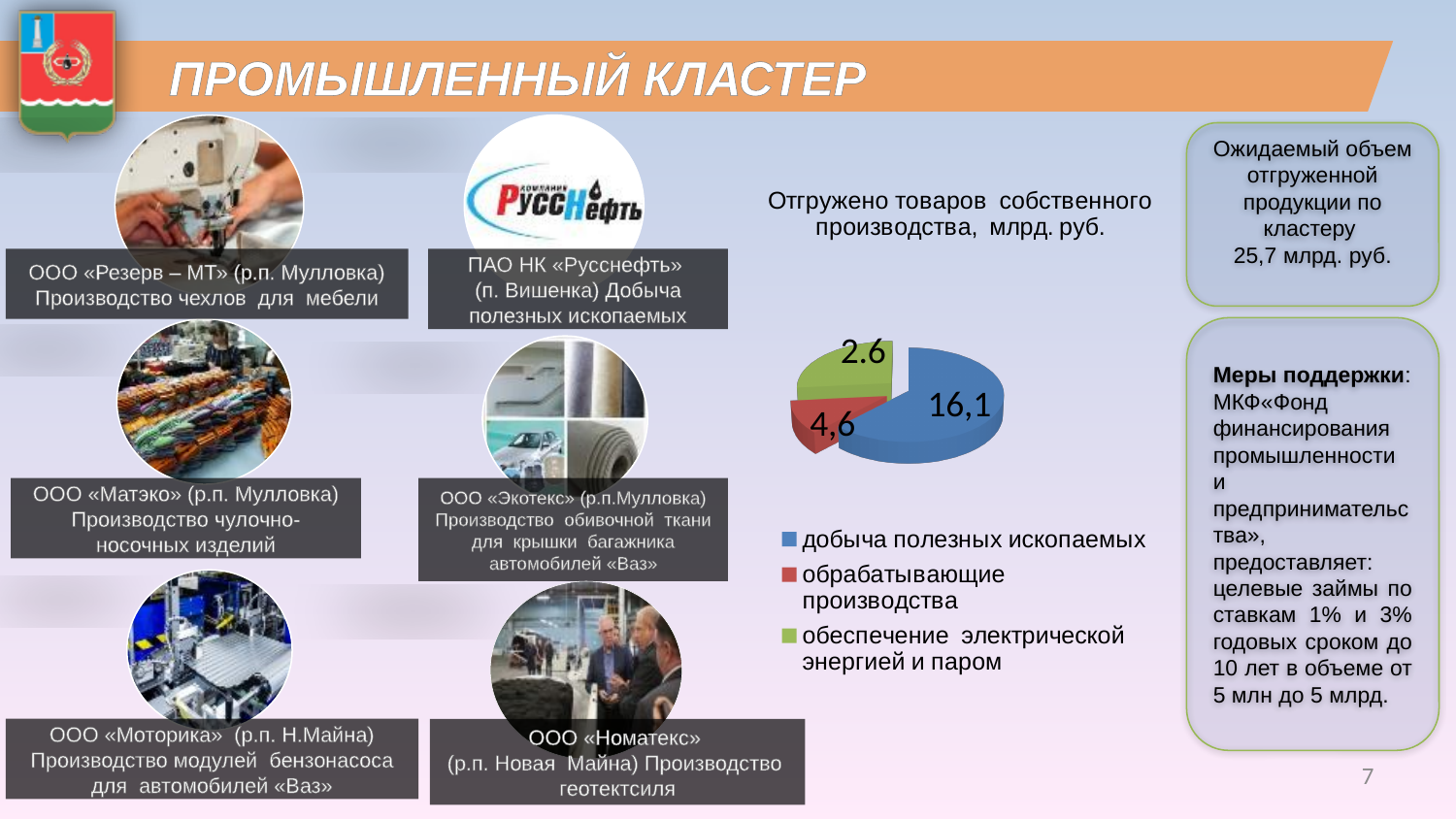
What is the title of the pie chart? Отгружено товаров собственного производства, млрд. руб. Which is larger: the value for обрабатывающие производства or the value for обеспечение электрической энергией и паром? обрабатывающие производства What is the total of all slices in the pie chart? 23,3 What kind of chart is shown on the slide? pie chart What is the value for добыча полезных ископаемых in the pie chart? 16,1 What is the difference between the values for добыча полезных ископаемых and обрабатывающие производства? 11,5 Which category has the largest slice in the pie chart? добыча полезных ископаемых What is the value for обеспечение электрической энергией и паром in the pie chart? 2.6 What is the value for обрабатывающие производства in the pie chart? 4,6 How many categories does the pie chart show? 3 What is the difference between the values for обрабатывающие производства and обеспечение электрической энергией и паром? 2,0